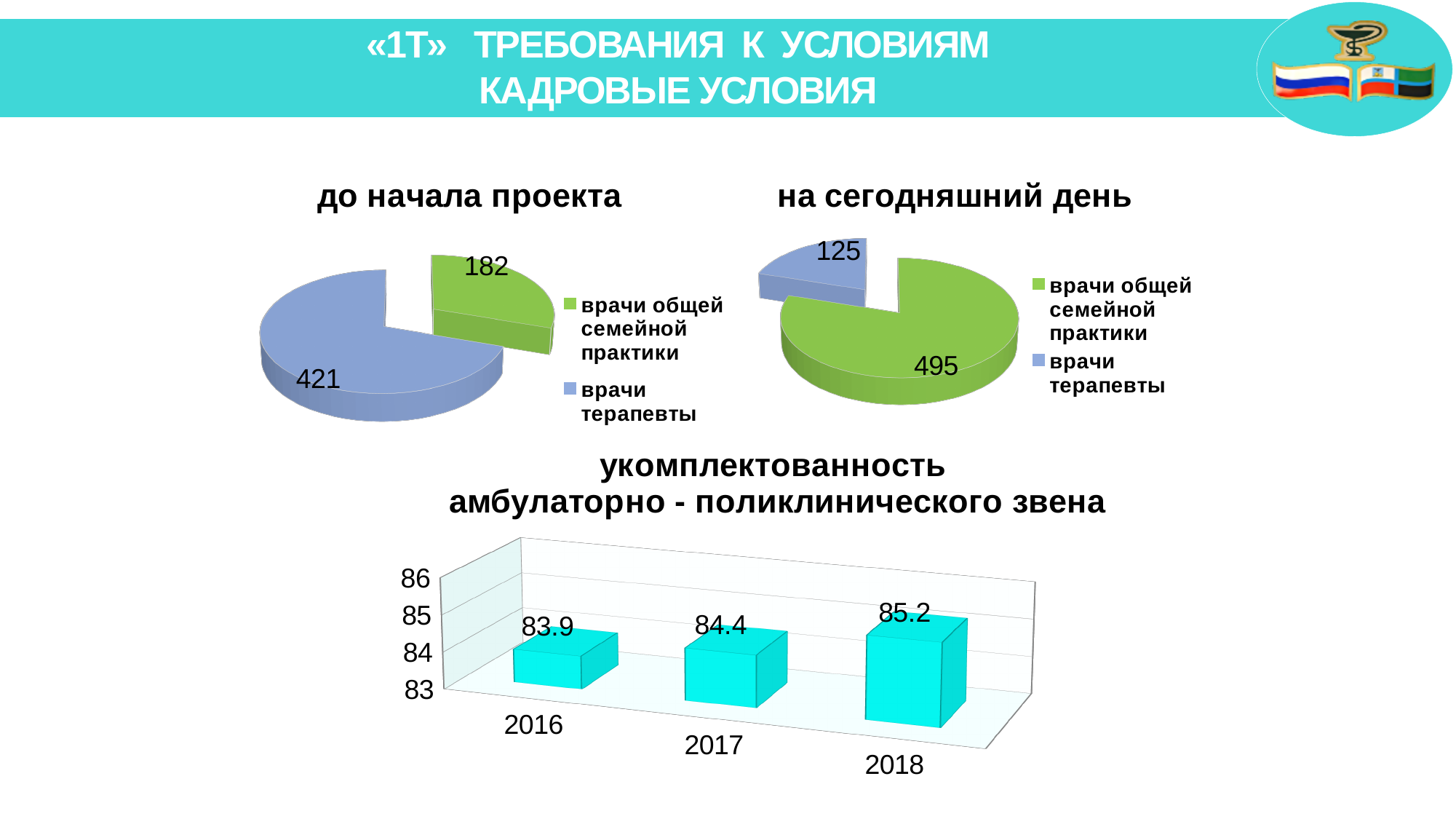
In the pie chart titled "на сегодняшний день", what share of the total do врачи терапевты represent? 20.2% In the pie chart titled "до начала проекта", what is the value for врачи общей семейной практики? 182 In the chart titled "укомплектованность амбулаторно - поликлинического звена", do the values rise or fall from 2016 to 2018? rise In the pie chart titled "на сегодняшний день", what is the value for врачи общей семейной практики? 495 In the chart titled "укомплектованность амбулаторно - поликлинического звена", what is the difference between the 2018 and 2016 values? 1.3 In the pie chart titled "на сегодняшний день", what is the value for врачи терапевты? 125 In the chart titled "укомплектованность амбулаторно - поликлинического звена", which year has the highest value? 2018 How many series does the legend of the pie chart titled "до начала проекта" list? 2 In the pie chart titled "до начала проекта", what is the value for врачи терапевты? 421 In the chart titled "укомплектованность амбулаторно - поликлинического звена", what is the value for 2017? 84.4 In the pie chart titled "на сегодняшний день", which category has the larger value? врачи общей семейной практики In the pie chart titled "до начала проекта", what is the difference between врачи терапевты and врачи общей семейной практики? 239